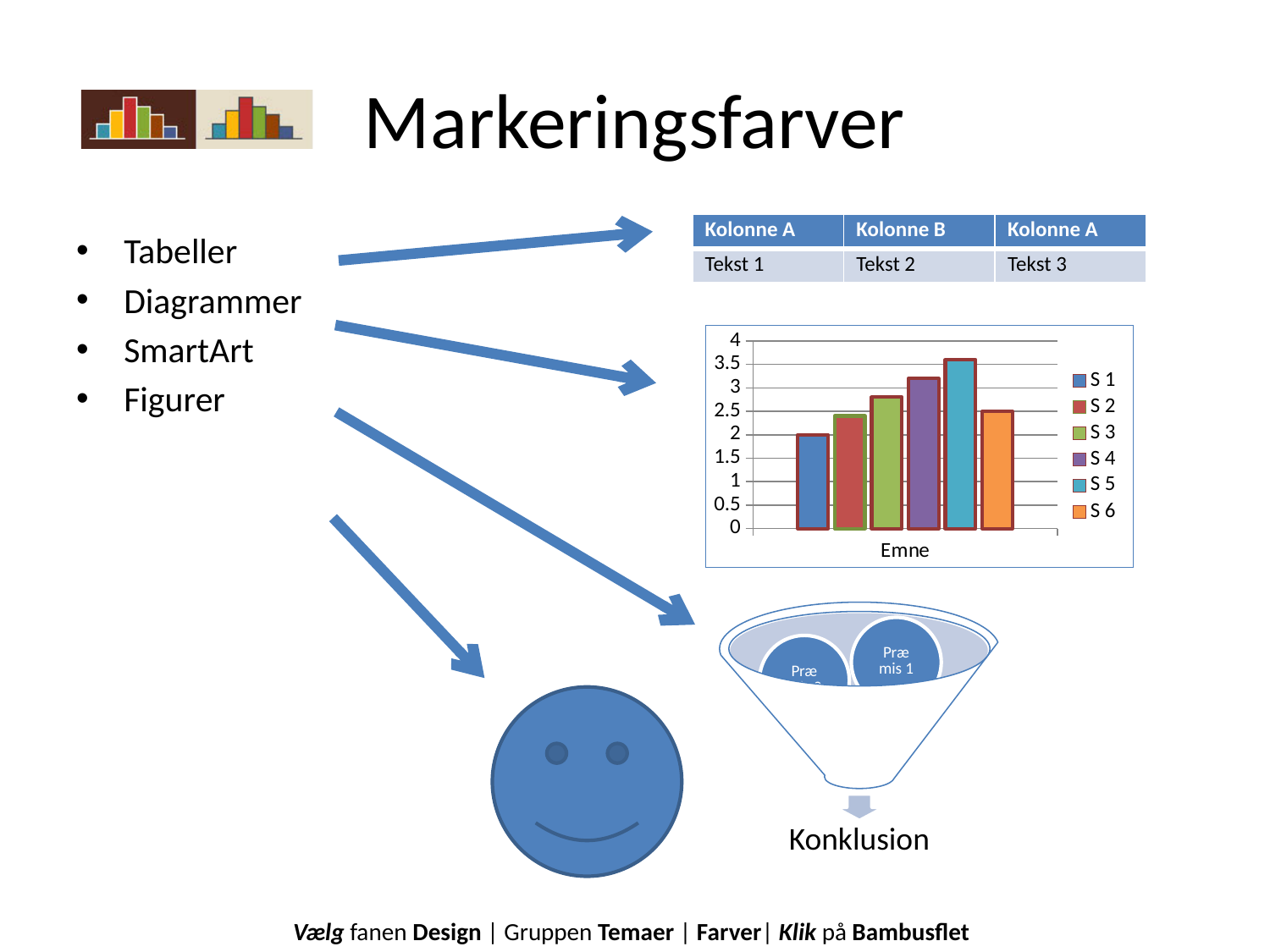
Which is larger in the chart, the bar for S 4 or the bar for S 2? S 4 What kind of chart is shown on the slide? bar chart Is the value for S 4 greater or less than 3? greater How many series does the chart's legend list? 6 How many categories are shown on the x axis of the chart? 1 Is the value for S 5 greater or less than 3? greater What is the value of the S 1 bar in the chart? 2 Which series has the highest bar in the chart? S 5 What is the highest value shown on the chart's y axis? 4 Which series has the lowest bar in the chart? S 1 Is the value for S 2 greater or less than 3? less What is the category label shown on the x axis of the chart? Emne